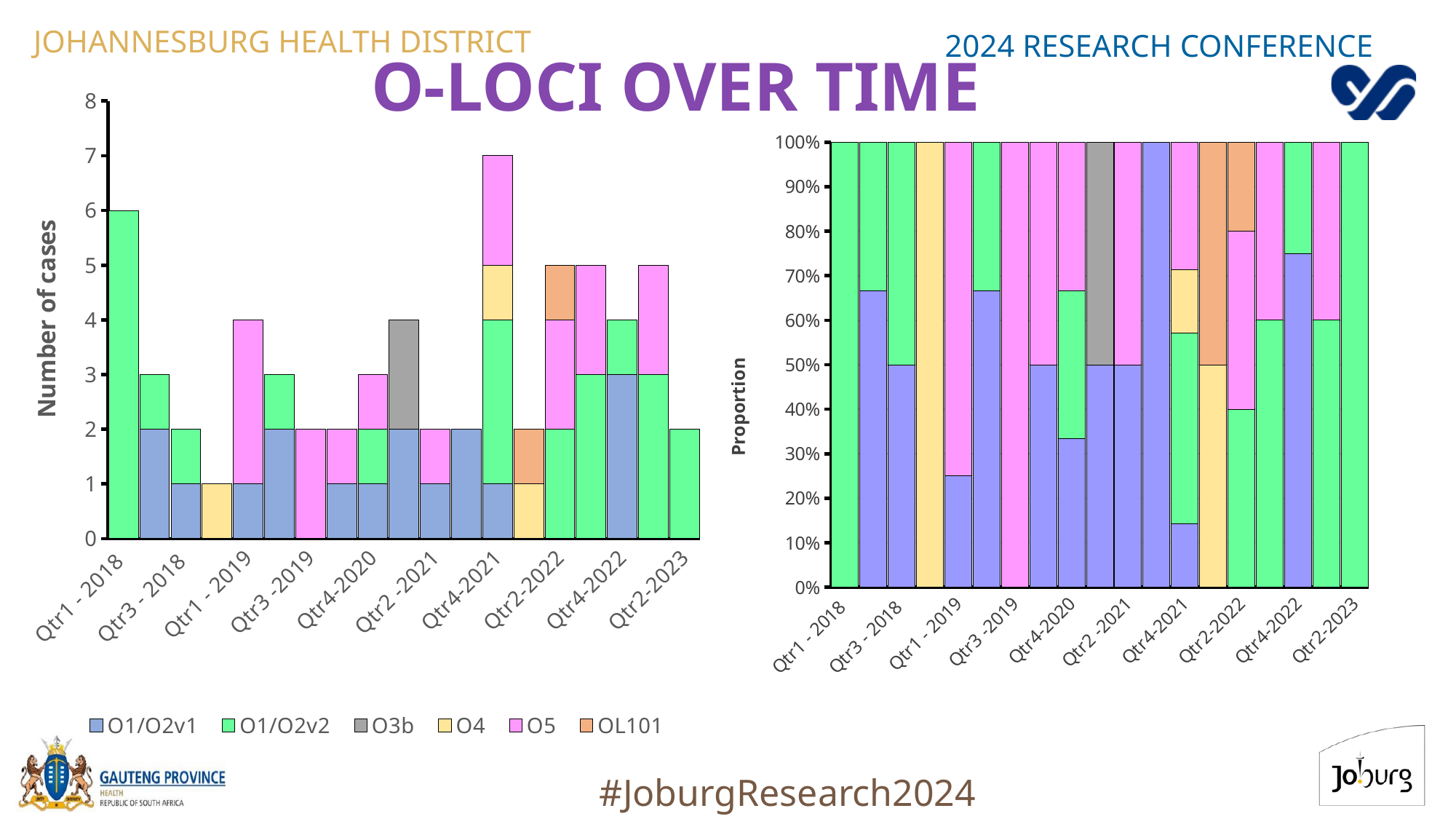
How many series does the legend list? 6 In the left chart (Number of cases), is the total number of cases for Qtr1 - 2019 greater or less than 3? greater In the right chart (Proportion), what proportion of cases in Qtr1 - 2019 is O1/O2v1? 25% In the left chart (Number of cases), what is the total number of cases for Qtr1 - 2018? 6 What is the title of the slide's charts? O-LOCI OVER TIME In the left chart (Number of cases), what is the difference between the total cases for Qtr4-2021 and Qtr1 - 2018? 1 In the left chart (Number of cases), which labelled quarter has the highest total number of cases? Qtr4-2021 In the right chart (Proportion), is the O1/O2v1 proportion for Qtr4-2022 greater or less than 70%? greater What kind of chart is the left chart (Number of cases)? Stacked bar chart In the right chart (Proportion), what proportion of cases in Qtr1 - 2018 is O1/O2v2? 100% In the left chart (Number of cases), what is the total number of cases for Qtr4-2021? 7 In the left chart (Number of cases), which has more cases in total: Qtr1 - 2018 or Qtr3 - 2018? Qtr1 - 2018